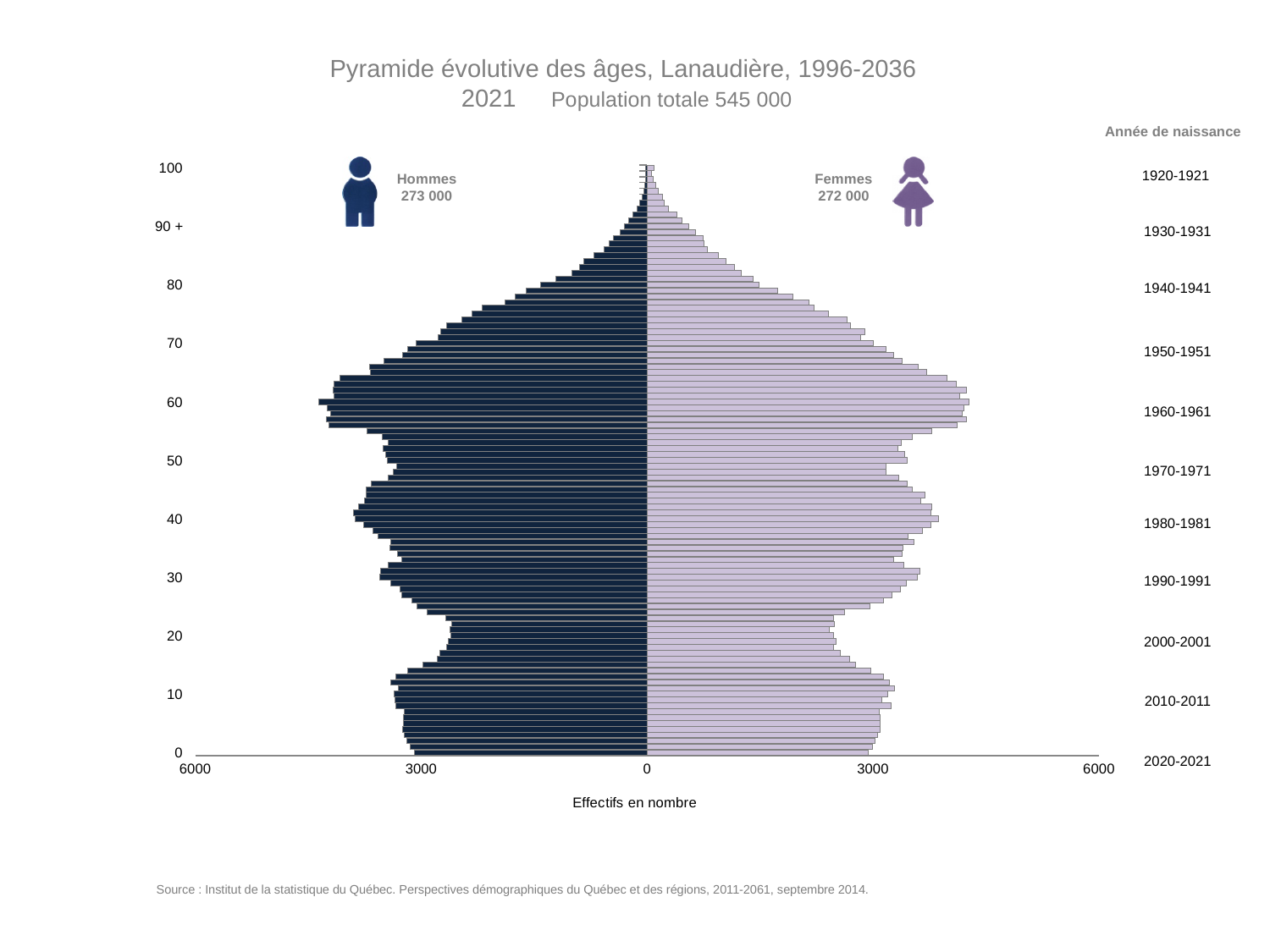
Is the value for women aged 60 greater or less than 3000? greater Is the value for men aged 80 greater or less than 3000? less What is the label of the horizontal axis? Effectifs en nombre What kind of chart is shown on the slide? Bar chart (population pyramid) Which year does the pyramid on the slide represent? 2021 What is the number of Femmes (women) shown on the chart? 272 000 Which group is larger, Hommes or Femmes? Hommes Is the value for men aged 60 greater or less than 3000? greater What is the difference between the number of Hommes and the number of Femmes? 1 000 Do the bars get longer or shorter as age increases from 60 to 100? shorter What is the number of Hommes (men) shown on the chart? 273 000 What is the total population shown on the slide? 545 000